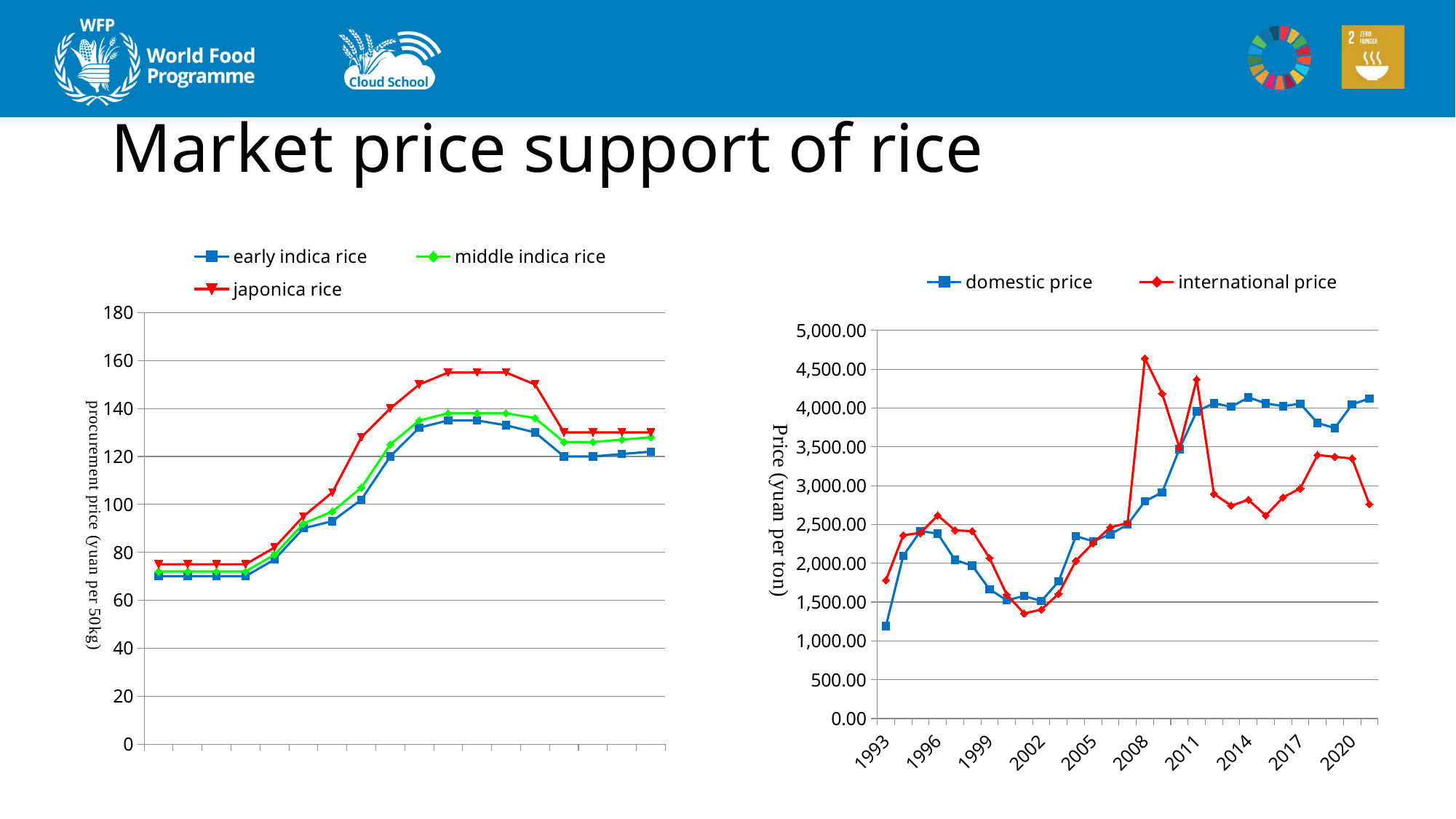
In the left chart, which series has the lowest procurement price at the end of the period? early indica rice How many series does the legend of the right chart list? 2 How many series does the legend of the left chart list? 3 In the right chart, which is larger in 2014, the domestic price or the international price? domestic price In the left chart, is the peak value for japonica rice greater or less than 140? greater In the left chart, is the peak value for early indica rice greater or less than 140? less In the right chart, is the domestic price in 1993 greater or less than 1,500.00? less In the left chart, which series has the highest procurement price at its peak? japonica rice What is the y-axis title of the left chart? procurement price (yuan per 50kg) What kind of chart is the left chart on the slide? line chart In the right chart, does the domestic price overall rise or fall from 1993 to 2020? rise